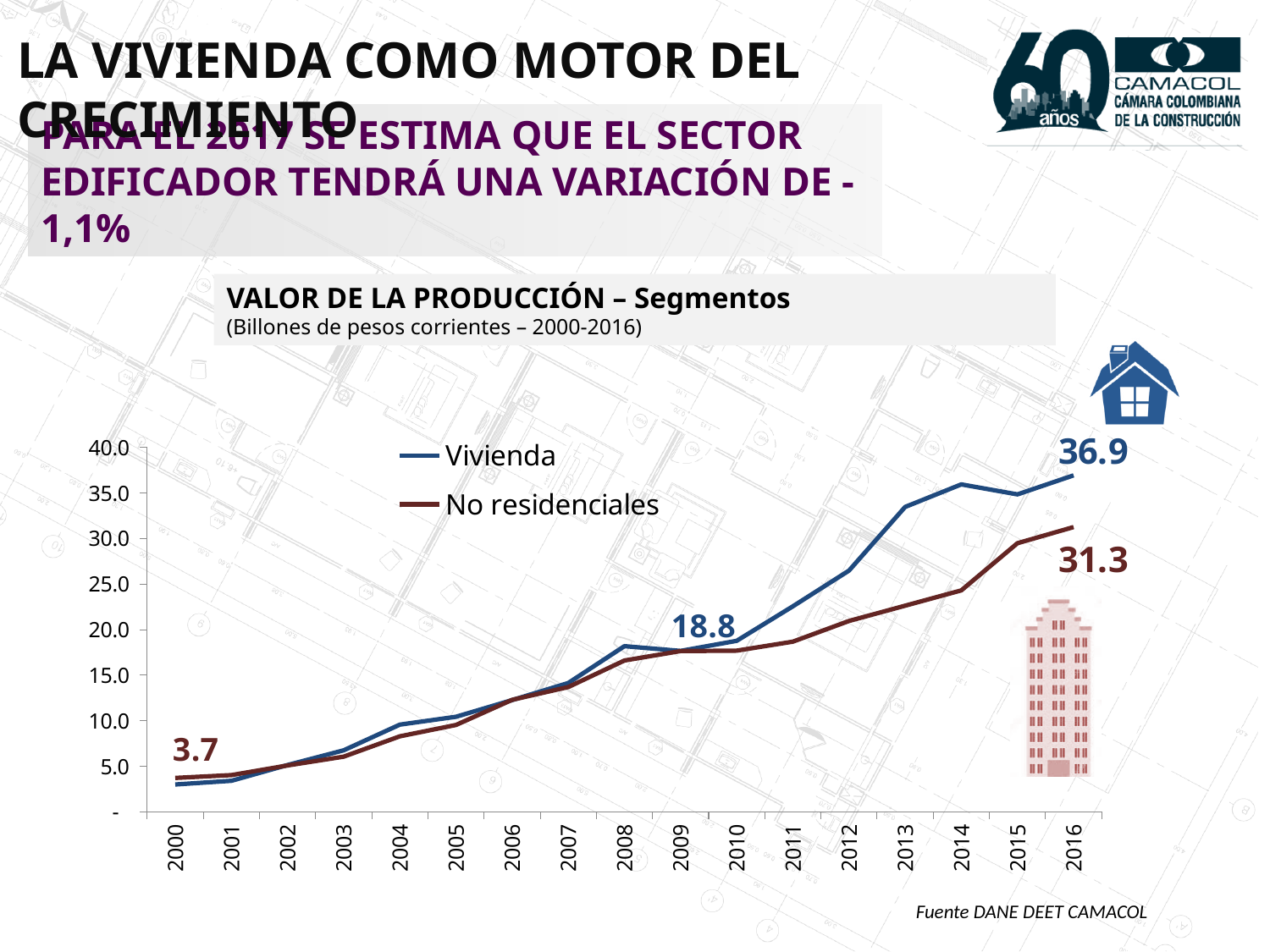
In 2016, which series has the larger value, Vivienda or No residenciales? Vivienda What is the value for Vivienda in 2016? 36.9 How many series does the legend list? 2 Is the value for Vivienda in 2013 greater or less than 30.0? greater Is the value for Vivienda in 2008 greater or less than 15.0? greater What is the value for Vivienda in 2010? 18.8 What is the difference between the Vivienda and No residenciales values in 2016? 5.6 Does the Vivienda series generally rise or fall from 2000 to 2016? Rise What kind of chart is shown on the slide? Line chart Is the value for No residenciales in 2010 greater or less than 20.0? less What is the value for No residenciales in 2016? 31.3 How many years are shown on the x axis? 17